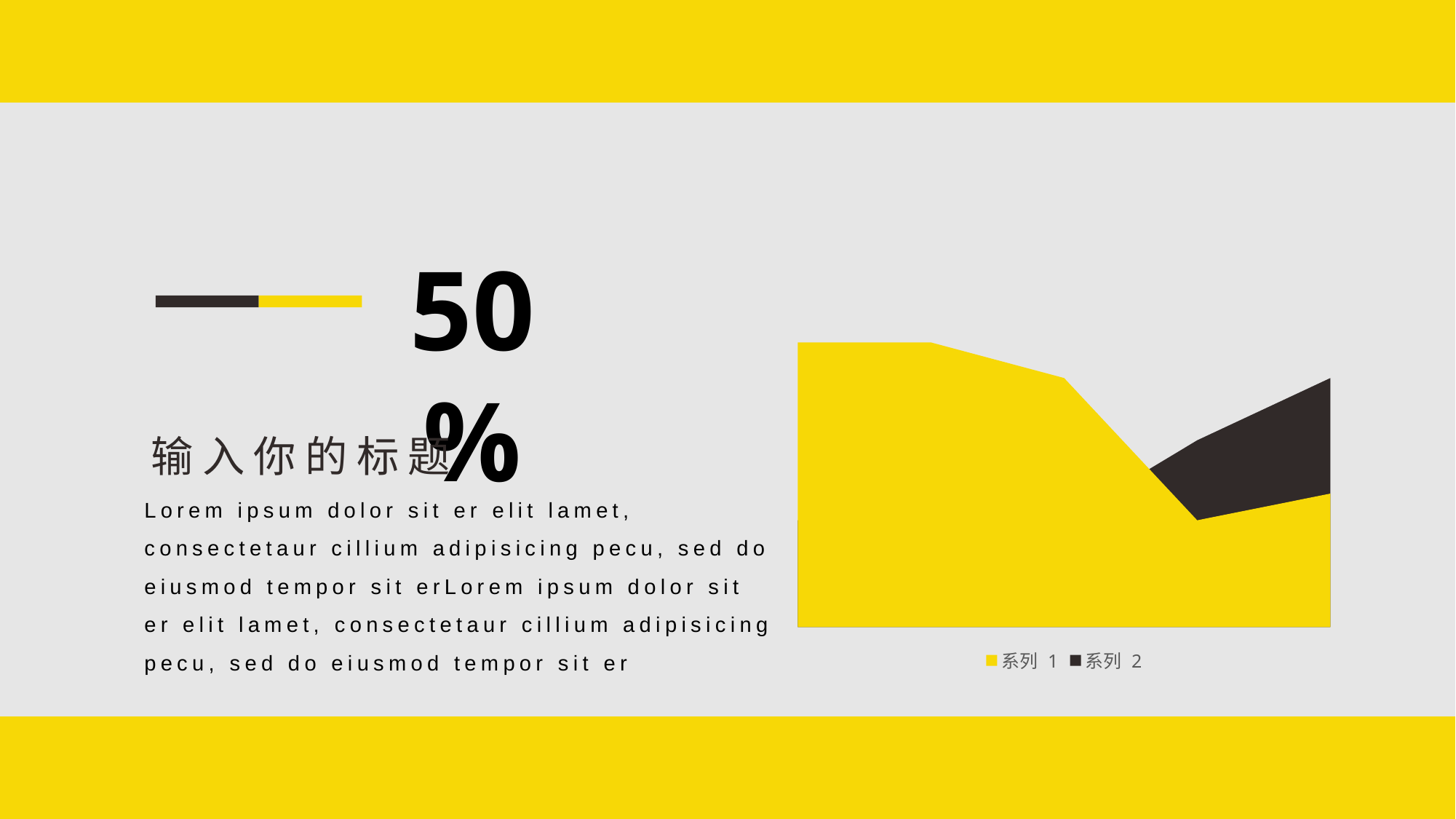
How many series does the chart's legend list? 2 Does the value of 系列 1 generally rise or fall from left to right across the chart? fall What kind of chart is shown on the slide? area chart Which colour represents 系列 1 in the chart? yellow How many data points does the 系列 1 area have along the x axis? 5 What are the names of the series listed in the chart's legend? 系列 1, 系列 2